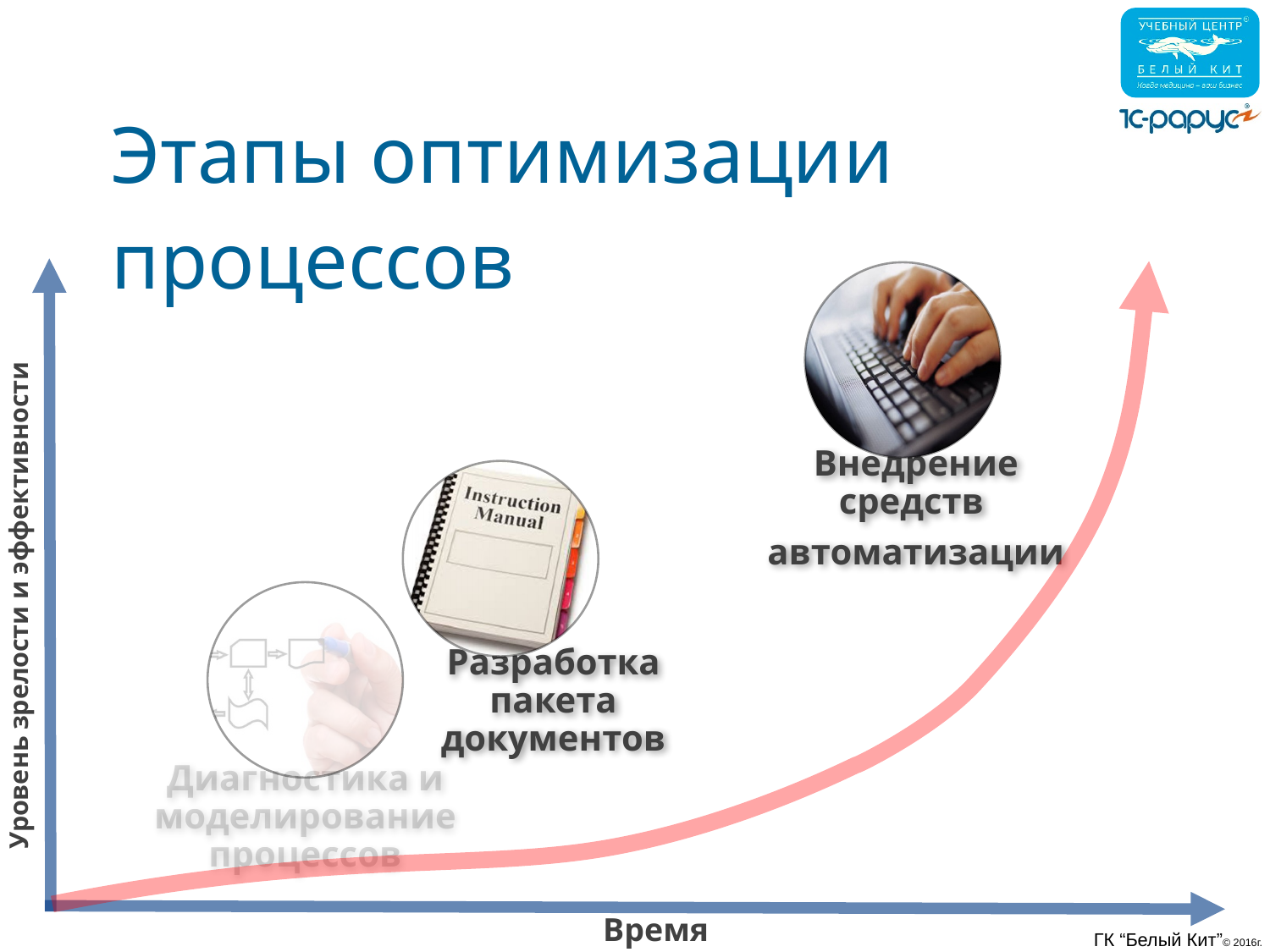
How many stages are marked along the curve on the chart? 3 Does the curve on the chart rise or fall as it moves along the x axis (Время)? rise What is the label of the horizontal axis of the chart? Время What is the label of the vertical axis of the chart? Уровень зрелости и эффективности